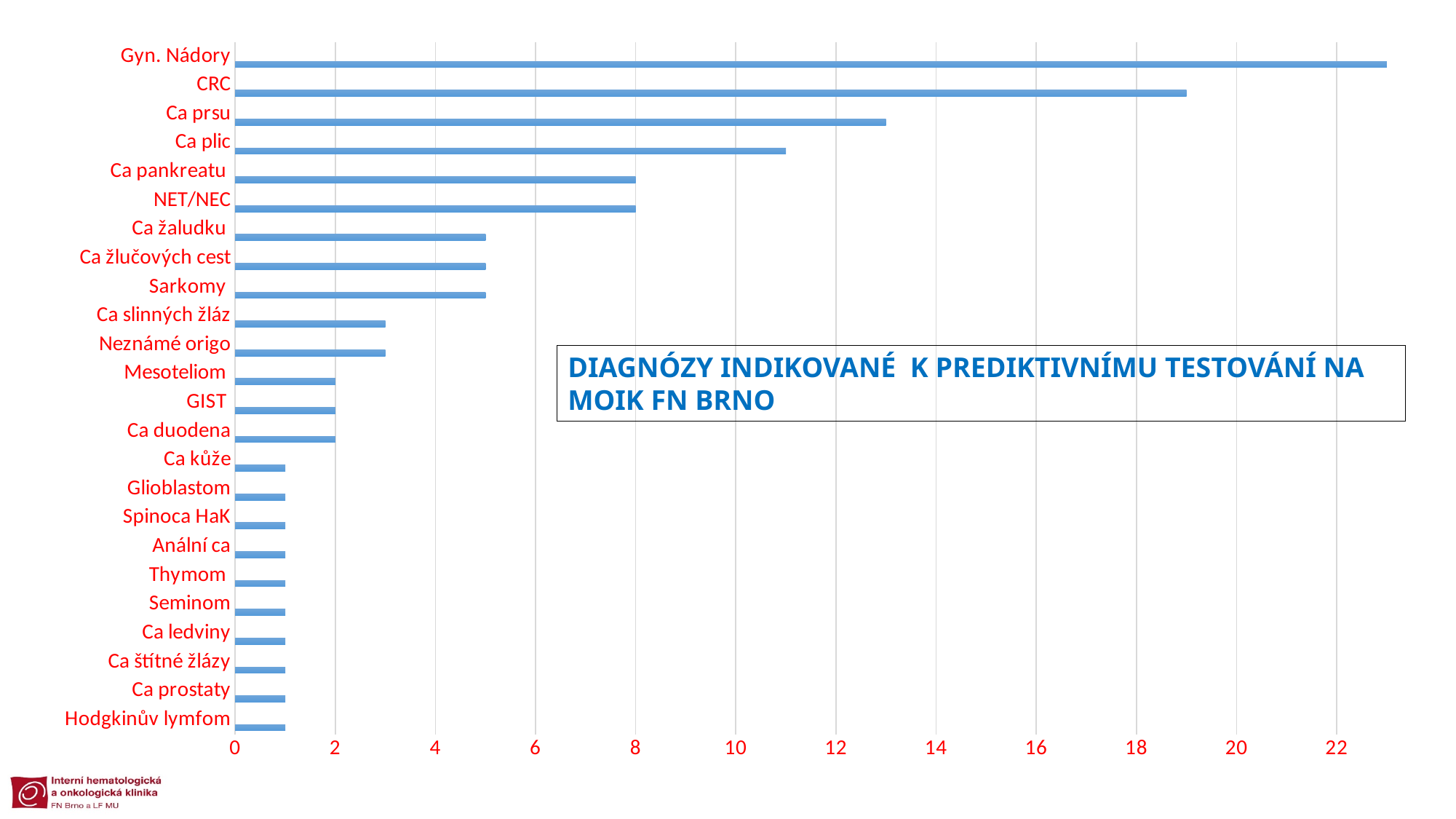
What is the value for Ca pankreatu? 8 How many categories are shown on the chart? 24 Is the value for CRC greater or less than 18? greater Is the value for Ca plic greater or less than 12? less What type of chart is shown on the slide? bar chart Is the value for Gyn. Nádory greater or less than 22? greater What is the value for NET/NEC? 8 What is the difference between the values for Ca pankreatu and Ca duodena? 6 What is the value for Mesoteliom? 2 Which has a larger value, CRC or Ca prsu? CRC What is the value for GIST? 2 Which category has the highest value? Gyn. Nádory